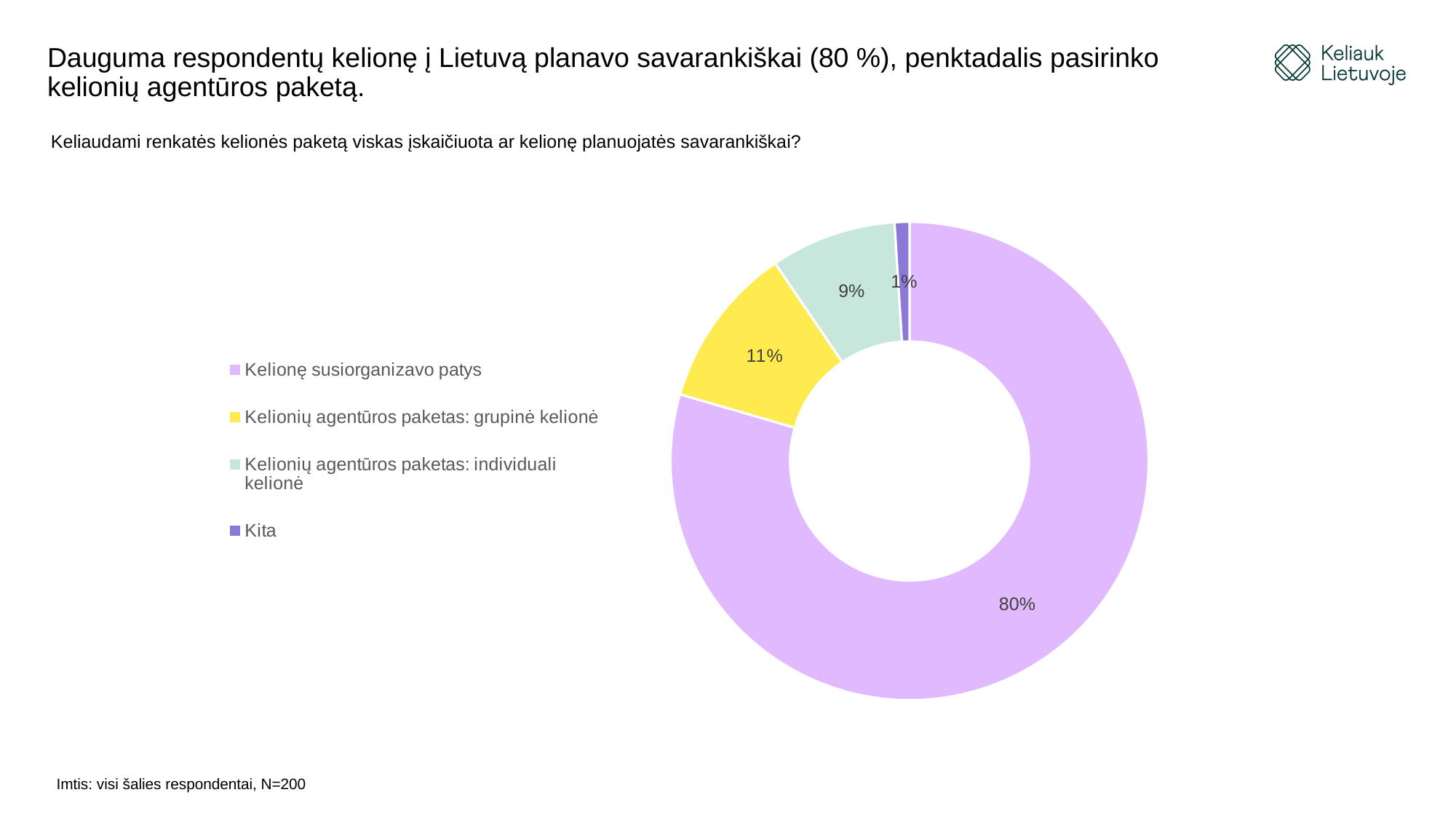
Which is larger: the share for 'Kelionių agentūros paketas: grupinė kelionė' or for 'Kelionių agentūros paketas: individuali kelionė'? Kelionių agentūros paketas: grupinė kelionė Which category has the smallest share of the pie? Kita What share of respondents does the 'Kelionę susiorganizavo patys' slice represent? 80% What kind of chart is shown on the slide? Pie chart (doughnut) What colour is the 'Kita' slice in the chart? Purple What is the combined share of the two 'Kelionių agentūros paketas' categories? 20% Which category has the largest share of the pie? Kelionę susiorganizavo patys What percentage is shown for 'Kelionių agentūros paketas: grupinė kelionė'? 11% What is the difference in percentage points between 'Kelionių agentūros paketas: grupinė kelionė' and 'Kelionių agentūros paketas: individuali kelionė'? 2 percentage points What percentage is shown for the 'Kita' slice? 1% What percentage is shown for 'Kelionių agentūros paketas: individuali kelionė'? 9% How many categories are shown in the chart? 4